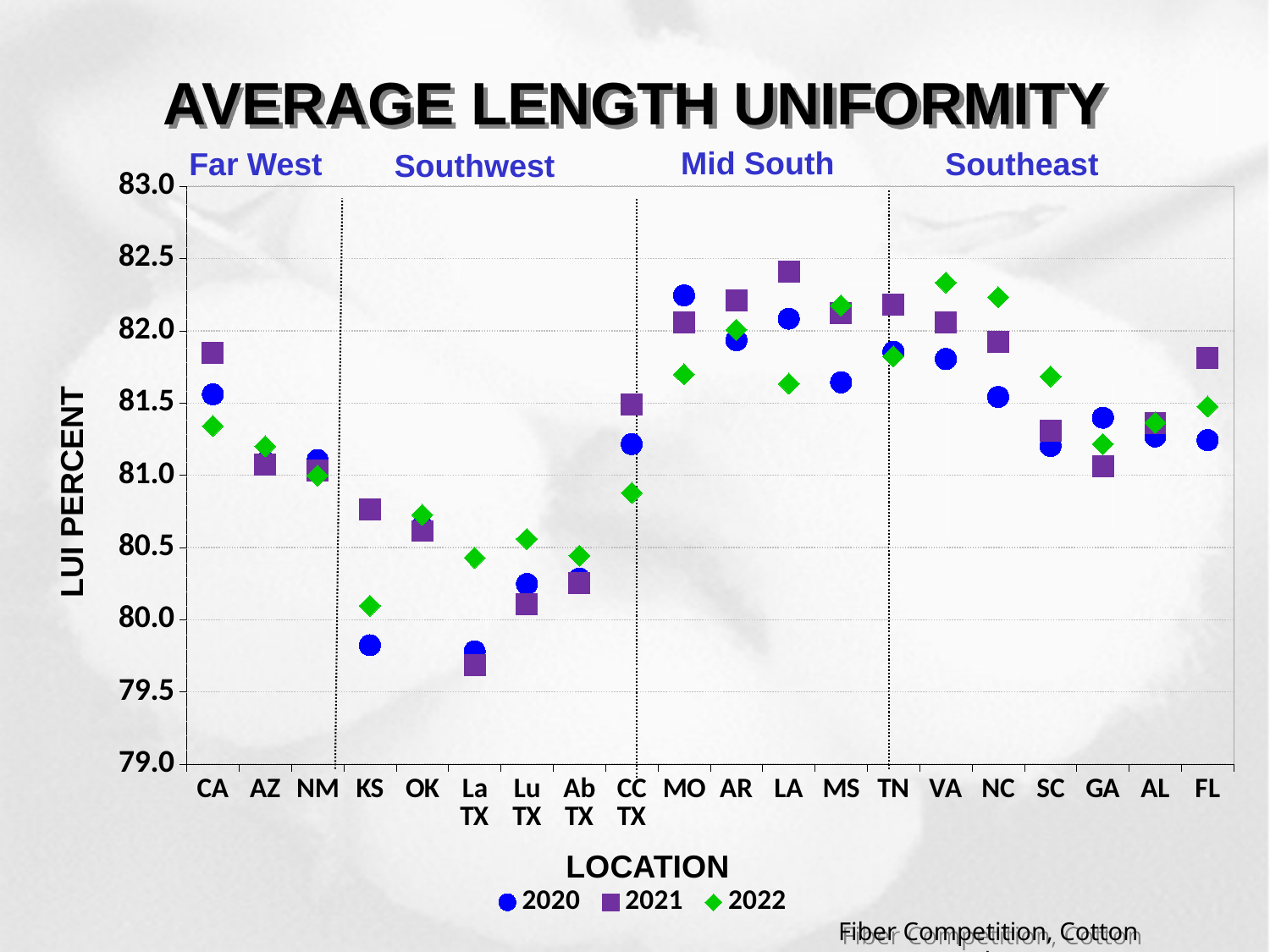
Is the 2020 value for MO greater or less than 82.0? greater What is the title of the chart? AVERAGE LENGTH UNIFORMITY Which is larger, the 2021 value for CA or the 2021 value for AZ? CA How many locations are plotted along the x axis? 20 Is the 2022 value for CC TX greater or less than 81.0? less Which location has the lowest 2021 value? La TX What kind of chart is shown on the slide? scatter chart How many series does the legend list? 3 Which location has the highest 2021 value? LA Is the 2020 value for KS greater or less than 80.0? less Do the 2021 values rise or fall from CA to NM in the Far West region? fall